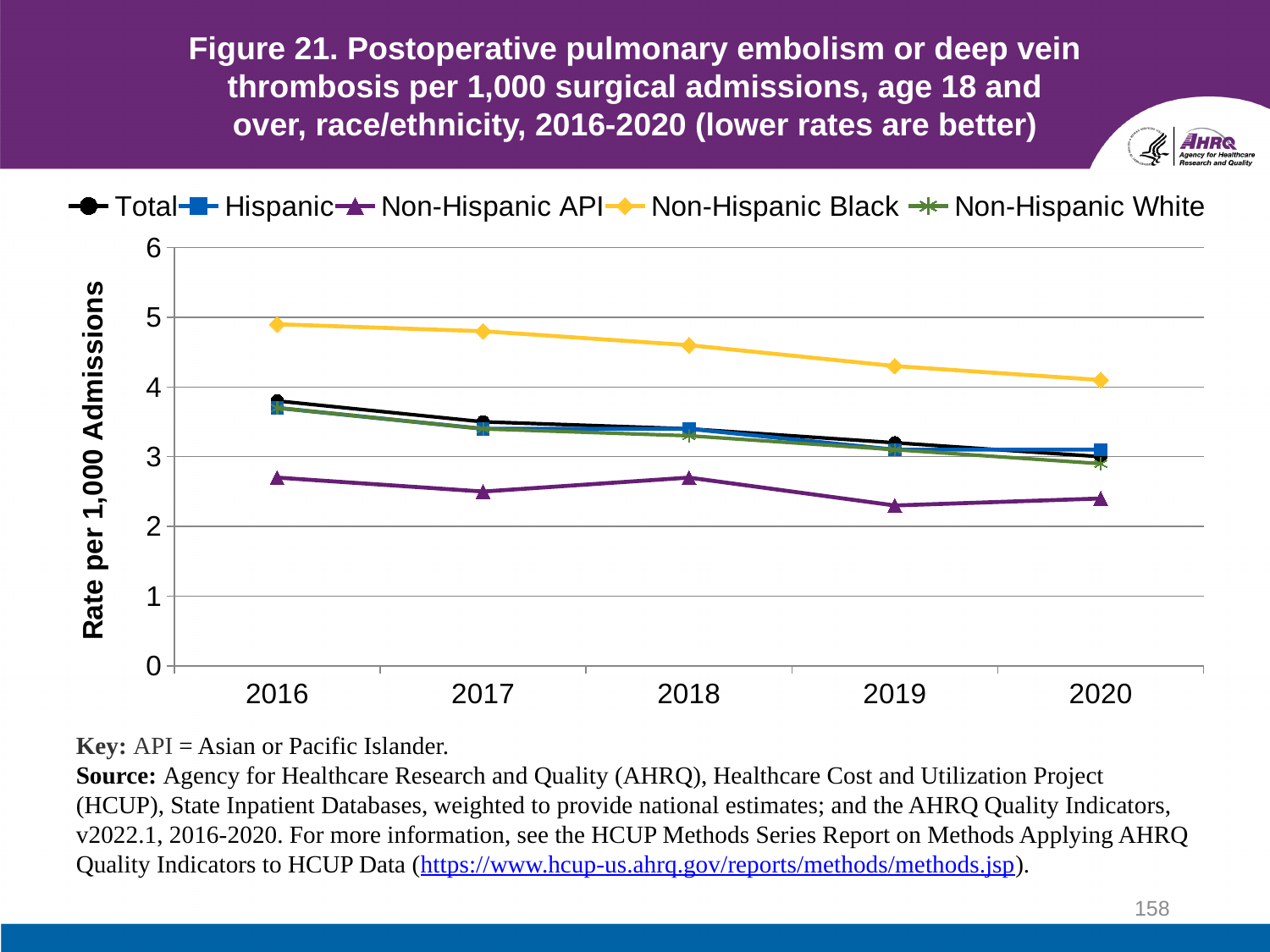
In 2018, which is larger: the rate for Non-Hispanic Black or the rate for Non-Hispanic API? Non-Hispanic Black How many series does the legend list? 5 Is the value for Total in 2016 greater or less than 4? less Which group has the highest rate in 2016? Non-Hispanic Black Is the value for Non-Hispanic Black in 2016 greater or less than 4? greater Is the value for Non-Hispanic API in 2019 greater or less than 3? less How many years are plotted along the x axis? 5 Which group has the lowest rate in 2020? Non-Hispanic API Does the Total rate rise or fall from 2016 to 2020? fall What kind of chart is shown on the slide? line chart Does the rate for Non-Hispanic Black rise or fall from 2016 to 2020? fall What is the label on the y axis? Rate per 1,000 Admissions